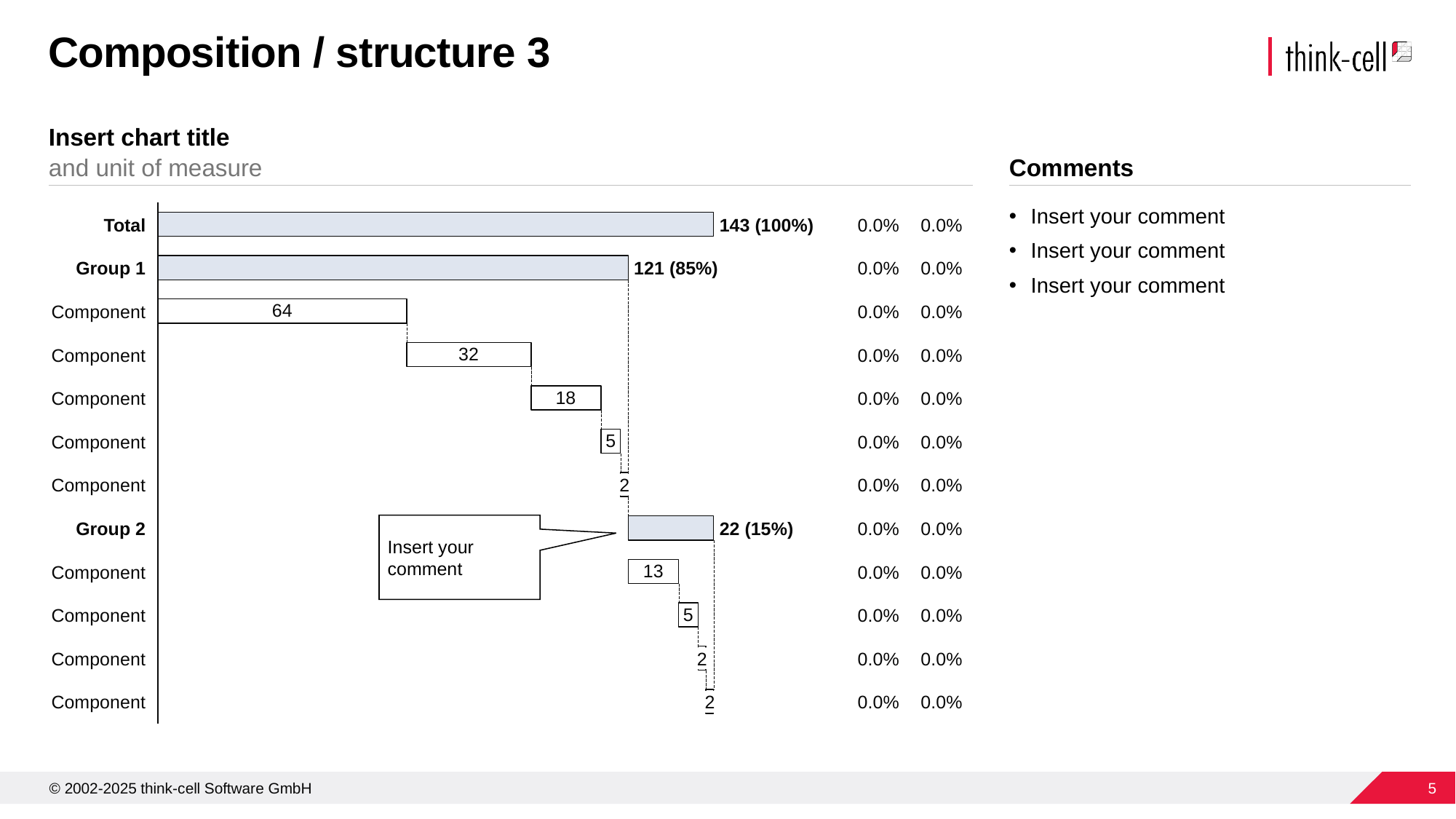
What is the difference between the values of Group 1 and Group 2? 99 What is the value of the first Component bar listed under Group 1? 64 Which of Group 1 and Group 2 has the larger value? Group 1 What is the value shown for Total? 143 (100%) What percentage share of the Total does Group 1 represent? 85% How many bars (rows) are plotted in the chart? 12 What percentage share of the Total does Group 2 represent? 15% What is the value shown for Group 2? 22 (15%) What kind of chart is shown on the slide? Bar chart (waterfall) What is the value of the first Component bar listed under Group 2? 13 Which category has the highest value in the chart? Total What is the value shown for Group 1? 121 (85%)